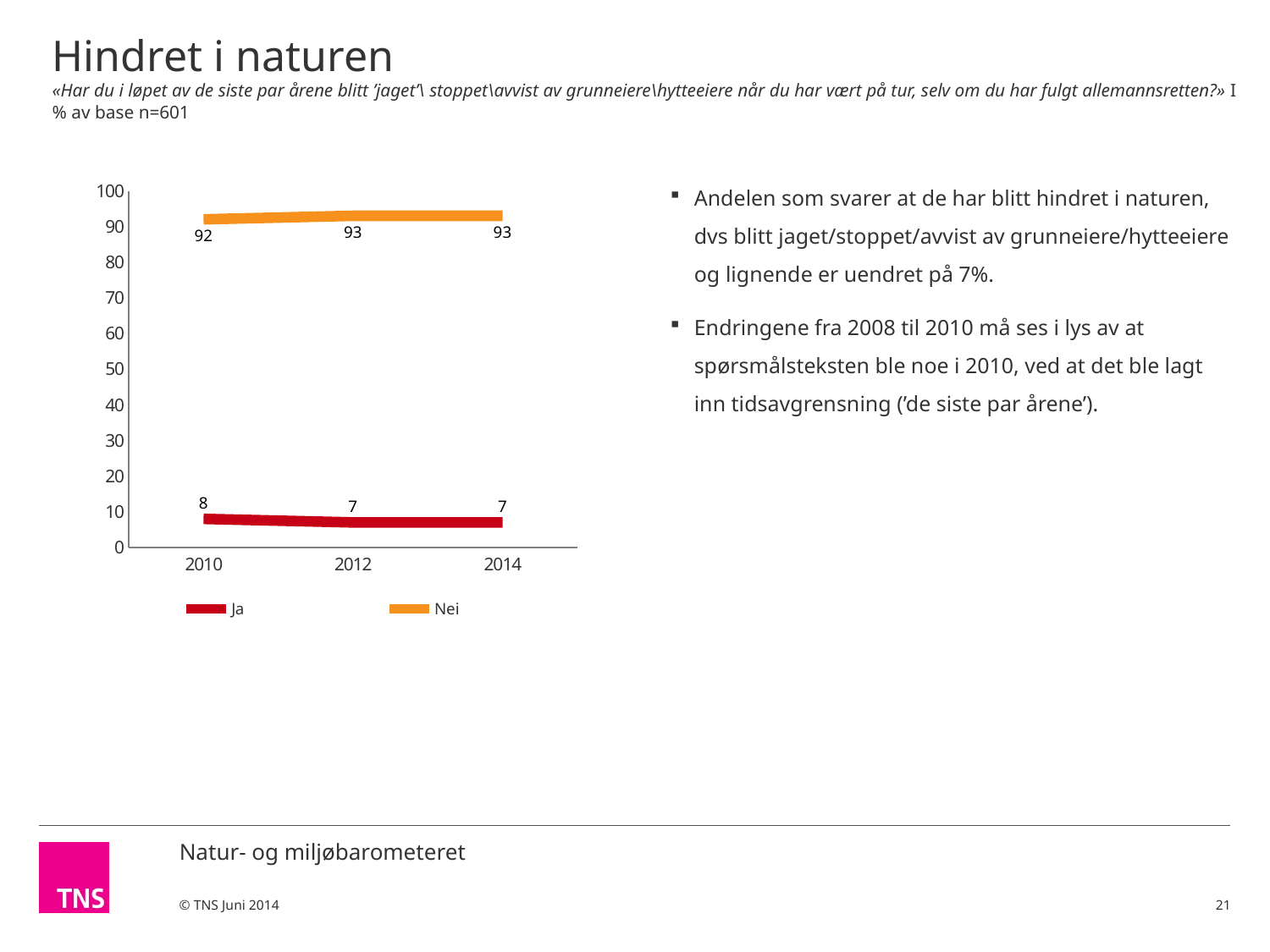
In which year is the Ja series highest? 2010 In which year is the Nei series lowest? 2010 How many series does the legend list? 2 What is the value for Ja in 2010? 8 What is the value for Ja in 2014? 7 How many years are shown on the x axis? 3 What is the value for Nei in 2010? 92 What is the difference between the Nei and Ja values in 2014? 86 What kind of chart is shown on the slide? line chart Is the value for Ja in 2012 greater or less than 50? less What is the value for Nei in 2012? 93 Which is larger in 2012, the Ja value or the Nei value? Nei